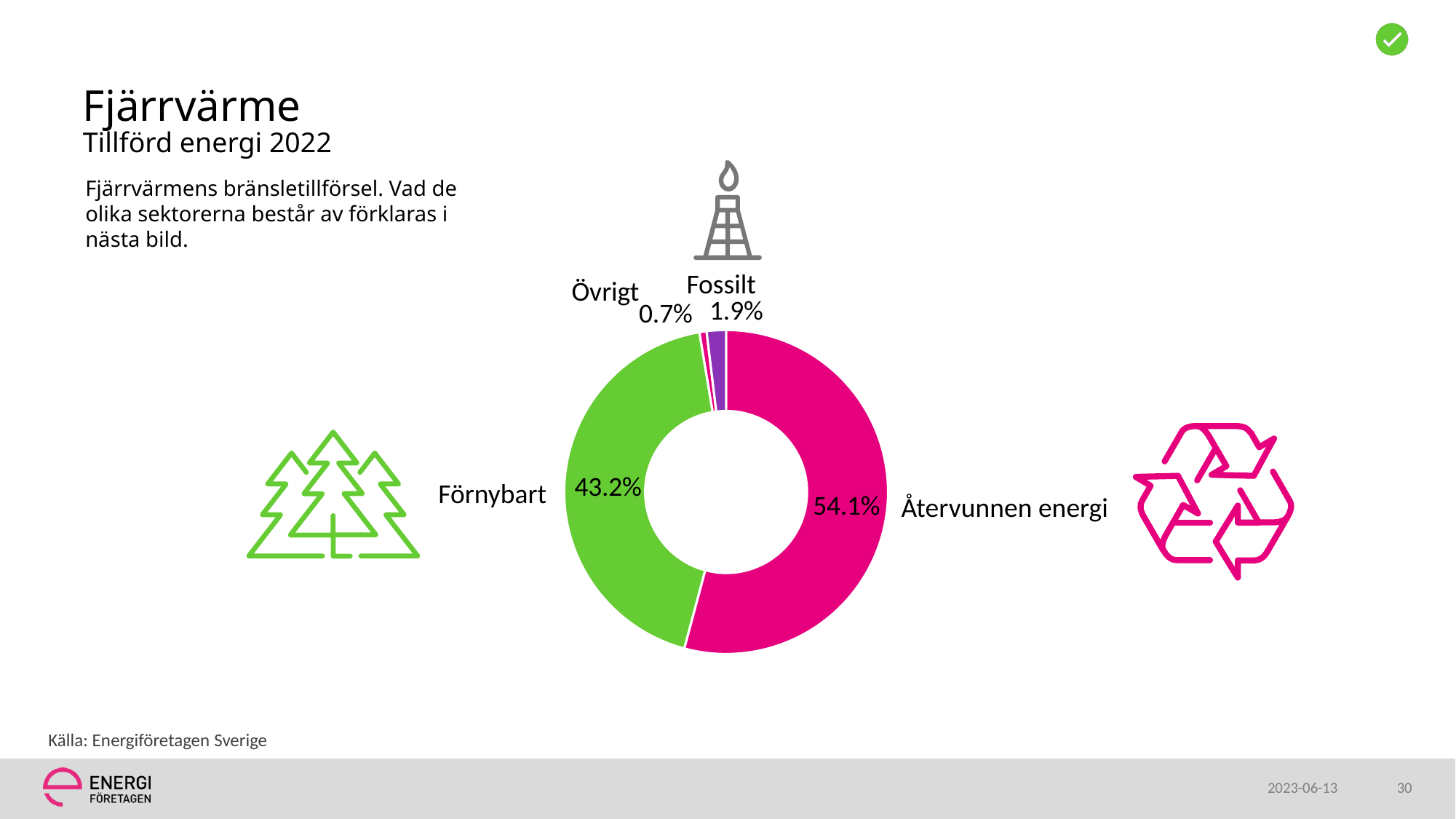
What share of the pie does Återvunnen energi have? 54.1% What kind of chart is shown on the slide? Pie chart (doughnut) What colour is the Förnybart slice? Green What is the value for Övrigt? 0.7% What is the difference between Återvunnen energi and Förnybart? 10.9% How many categories are shown in the chart? 4 What is the value for Förnybart? 43.2% Which category has the smallest share? Övrigt What is the value for Fossilt? 1.9% Which category has the largest share? Återvunnen energi What is the difference between Fossilt and Övrigt? 1.2% Which is larger, Fossilt or Övrigt? Fossilt